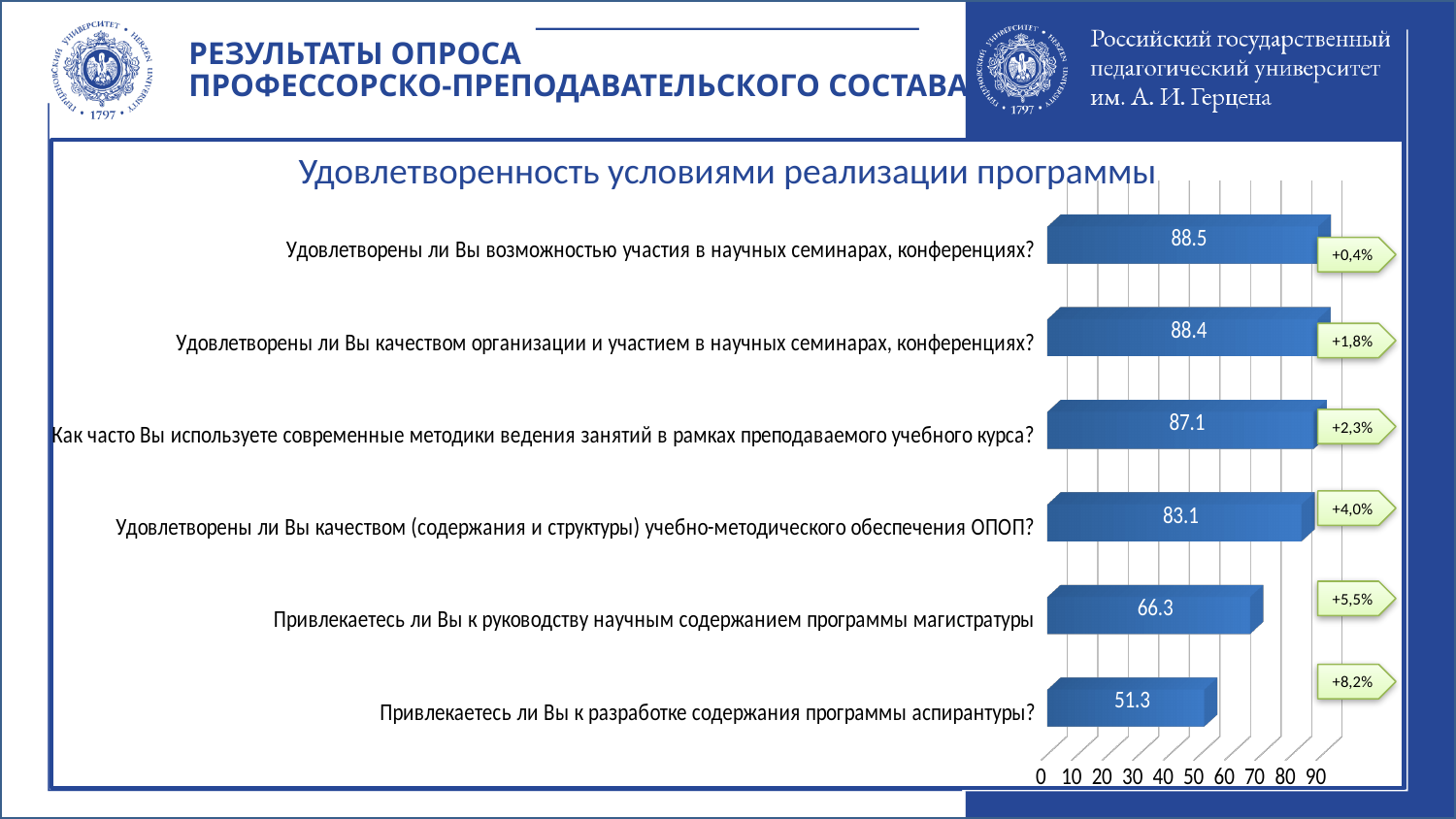
What change is shown in the green arrow next to the bar for "Привлекаетесь ли Вы к разработке содержания программы аспирантуры?"? +8,2% What value is shown for "Удовлетворены ли Вы качеством (содержания и структуры) учебно-методического обеспечения ОПОП?"? 83.1 Which is larger: the value for "Удовлетворены ли Вы качеством (содержания и структуры) учебно-методического обеспечения ОПОП?" or the value for "Привлекаетесь ли Вы к руководству научным содержанием программы магистратуры"? Удовлетворены ли Вы качеством (содержания и структуры) учебно-методического обеспечения ОПОП? What kind of chart is shown on the slide? bar chart Is the value for "Привлекаетесь ли Вы к руководству научным содержанием программы магистратуры" greater or less than 70? less What is the title of the chart? Удовлетворенность условиями реализации программы Which category has the lowest value? Привлекаетесь ли Вы к разработке содержания программы аспирантуры? What value is shown for "Привлекаетесь ли Вы к руководству научным содержанием программы магистратуры"? 66.3 What is the difference between the values for "Как часто Вы используете современные методики ведения занятий в рамках преподаваемого учебного курса?" and "Привлекаетесь ли Вы к разработке содержания программы аспирантуры?"? 35.8 How many categories are shown in the chart? 6 Which category has the highest value? Удовлетворены ли Вы возможностью участия в научных семинарах, конференциях? What value is shown for "Привлекаетесь ли Вы к разработке содержания программы аспирантуры?"? 51.3